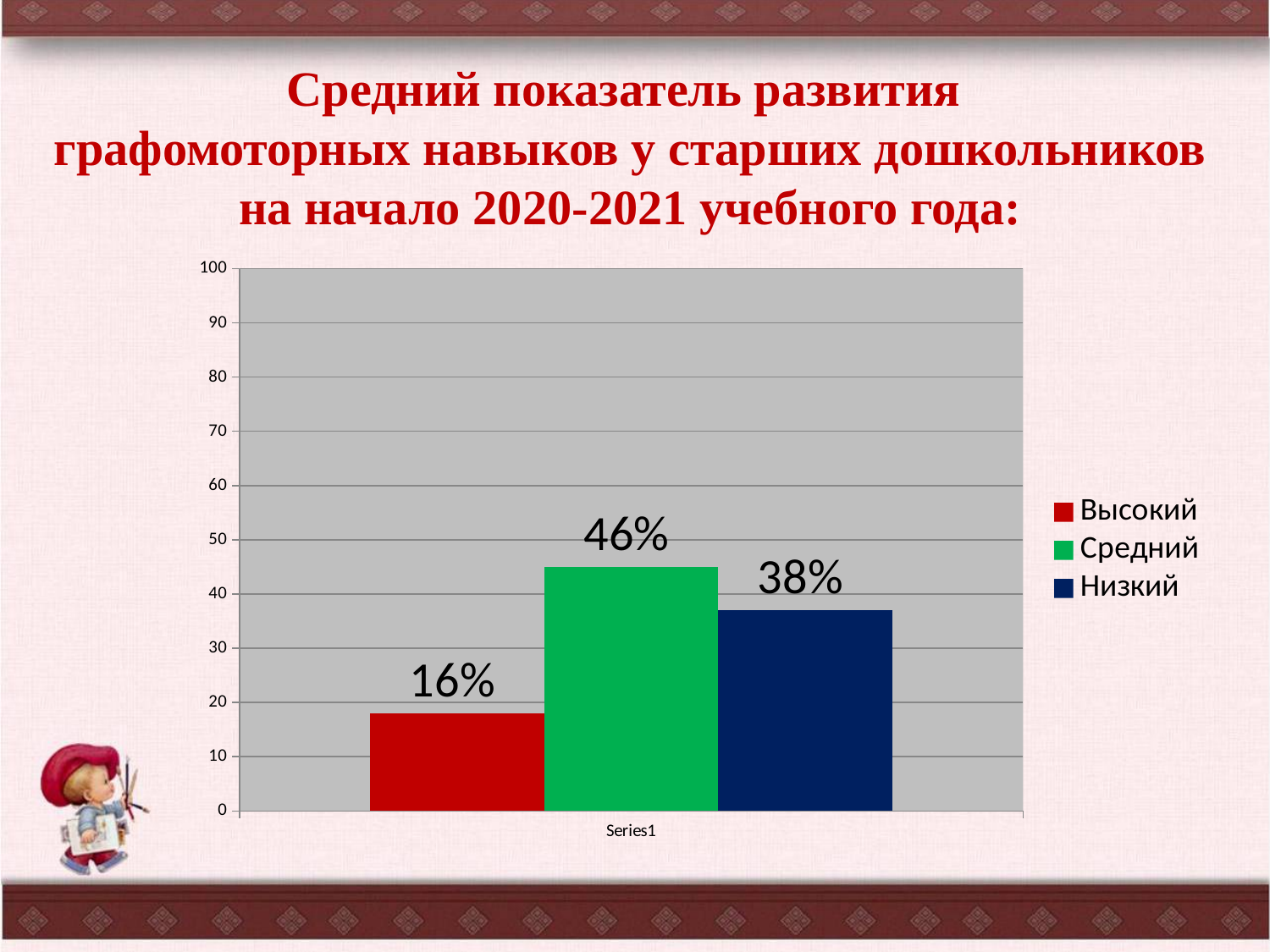
How many series does the legend list? 3 What colour is the bar for Средний? green What is the value for Средний? 46% Which is larger, the value for Низкий or the value for Высокий? Низкий Which level has the highest value? Средний What kind of chart is shown on the slide? bar chart What is the difference between the values for Средний and Низкий? 8% What is the value for Высокий? 16% Which level has the lowest value? Высокий Is the value for Средний greater or less than 40? greater What is the difference between the values for Низкий and Высокий? 22% What is the value for Низкий? 38%